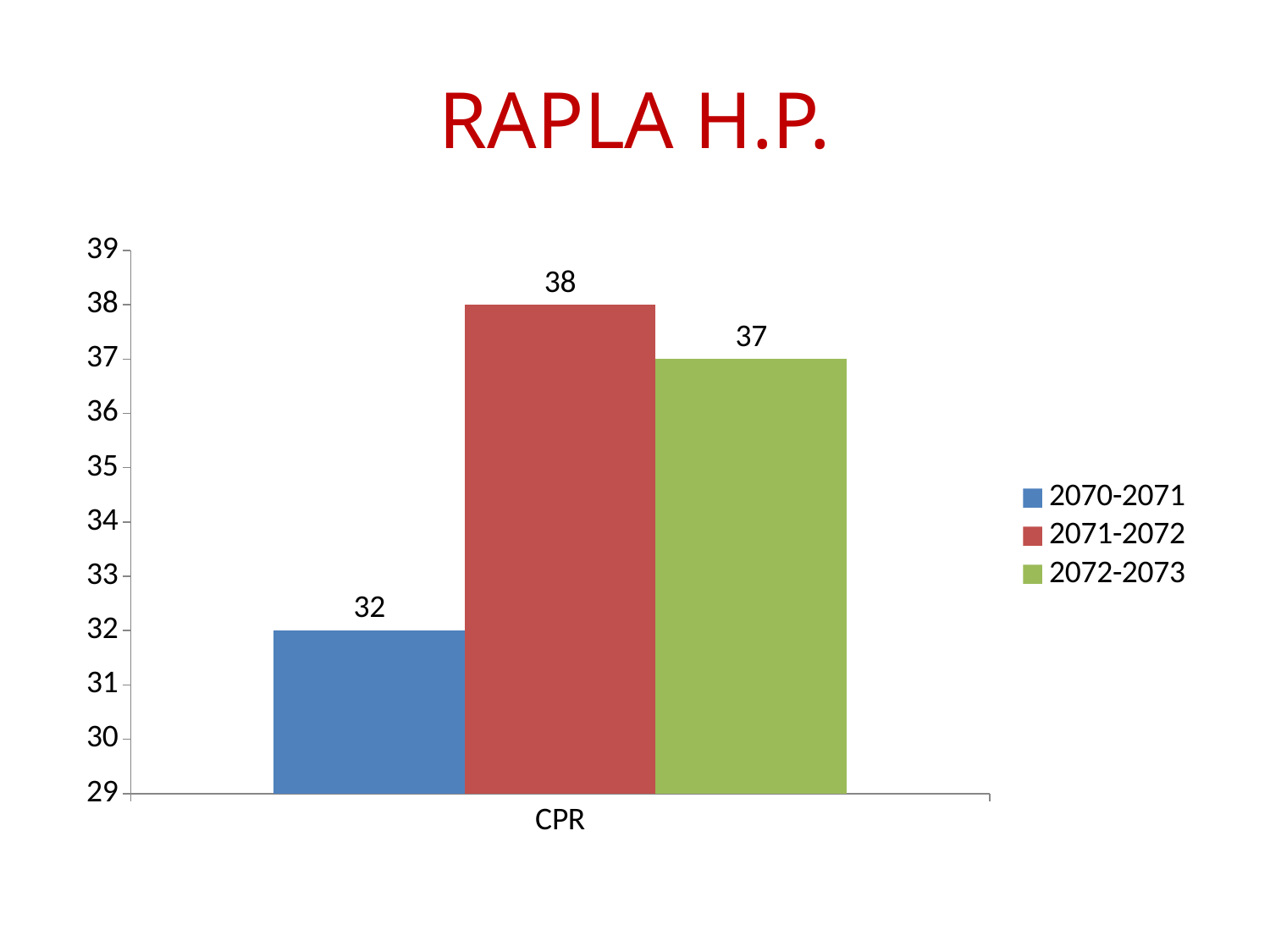
Which year has the lowest CPR value? 2070-2071 Which year has the highest CPR value? 2071-2072 Which is larger, the CPR value for 2070-2071 or for 2072-2073? 2072-2073 How many series does the legend list? 3 What is the difference between the CPR values for 2071-2072 and 2072-2073? 1 What is the title of the slide? RAPLA H.P. What is the difference between the CPR values for 2071-2072 and 2070-2071? 6 What is the CPR value for 2071-2072? 38 What is the CPR value for 2072-2073? 37 Is the CPR value for 2070-2071 greater or less than 35? less What is the CPR value for 2070-2071? 32 What kind of chart is shown on the slide? bar chart